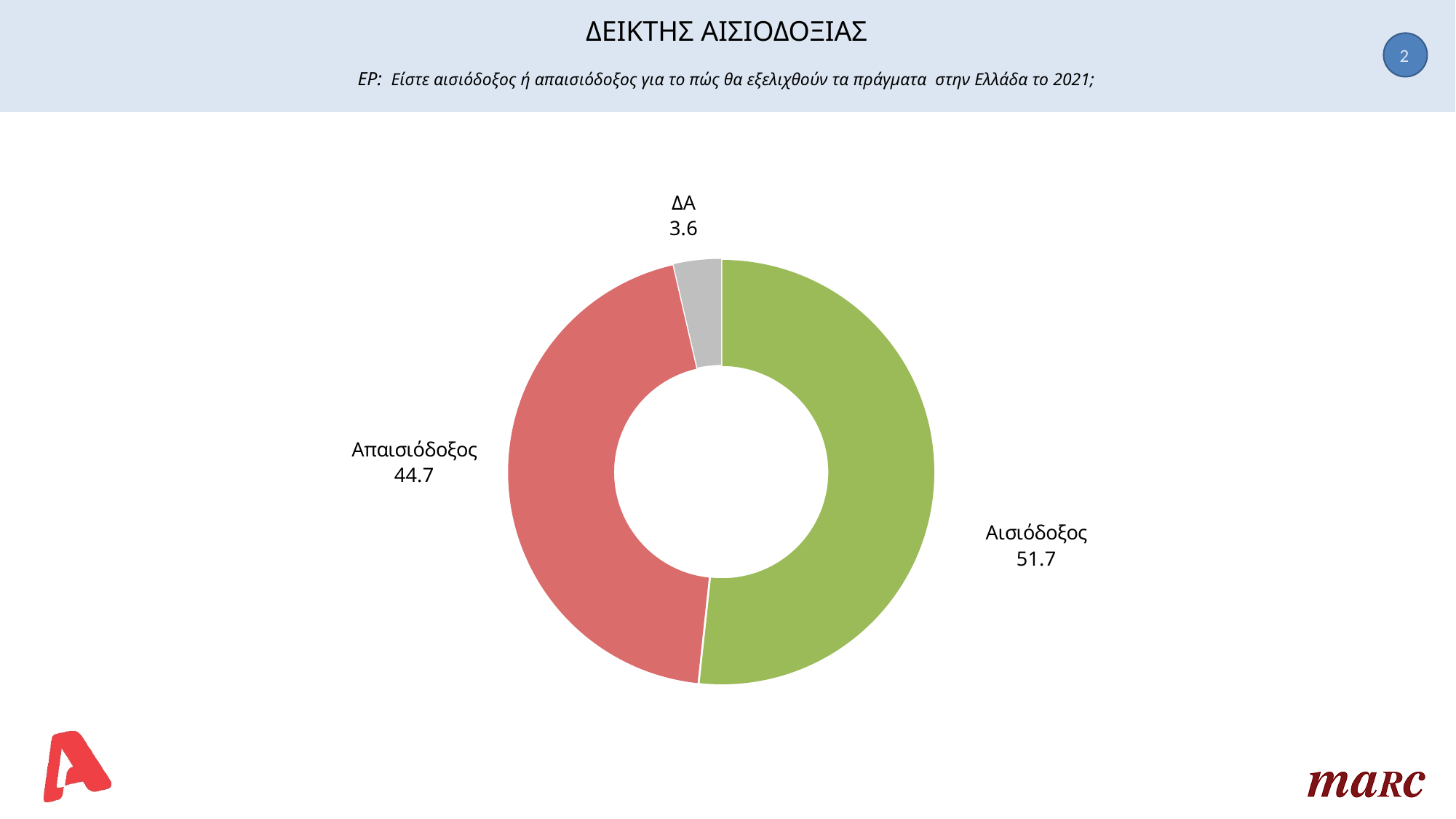
What is the value for Απαισιόδοξος? 44.7 What is the value for Αισιόδοξος? 51.7 Which is larger, Απαισιόδοξος or ΔΑ? Απαισιόδοξος What is the title of the slide? ΔΕΙΚΤΗΣ ΑΙΣΙΟΔΟΞΙΑΣ What is the value for ΔΑ? 3.6 What is the difference between the values for Αισιόδοξος and Απαισιόδοξος? 7.0 What colour is the Αισιόδοξος slice? Green Which category has the smallest slice? ΔΑ What is the difference between the values for Απαισιόδοξος and ΔΑ? 41.1 What kind of chart is shown on the slide? Doughnut (pie) chart How many categories are shown in the chart? 3 Which category has the largest slice? Αισιόδοξος